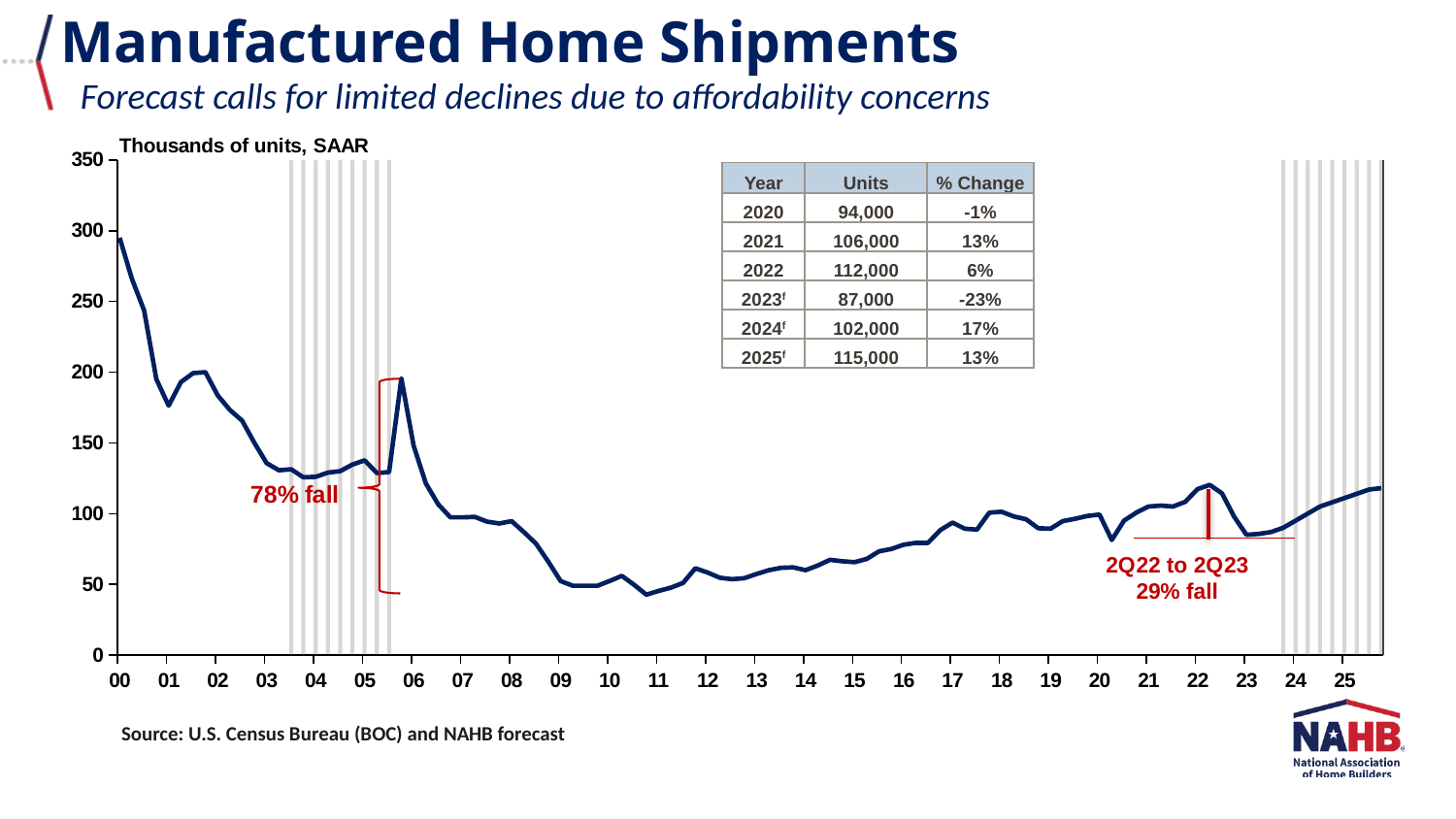
What unit is the y axis of the chart measured in? Thousands of units, SAAR Is the value of the line at the start of 2000 greater or less than 250? greater According to the table on the chart, how many units are forecast for 2025? 115,000 Which year in the table has the lowest number of units? 2023 According to the table on the chart, what is the % change forecast for 2023? -23% What percentage fall does the chart annotate for 2Q22 to 2Q23? 29% Which year in the table has the highest number of units? 2025 What kind of chart is shown on the slide? Line chart What is the title of the chart? Manufactured Home Shipments What is the difference in units between the 2025 forecast and the 2024 forecast in the table? 13,000 According to the table on the chart, how many units were shipped in 2022? 112,000 Do the values on the line rise or fall between 2000 and 2003? Fall